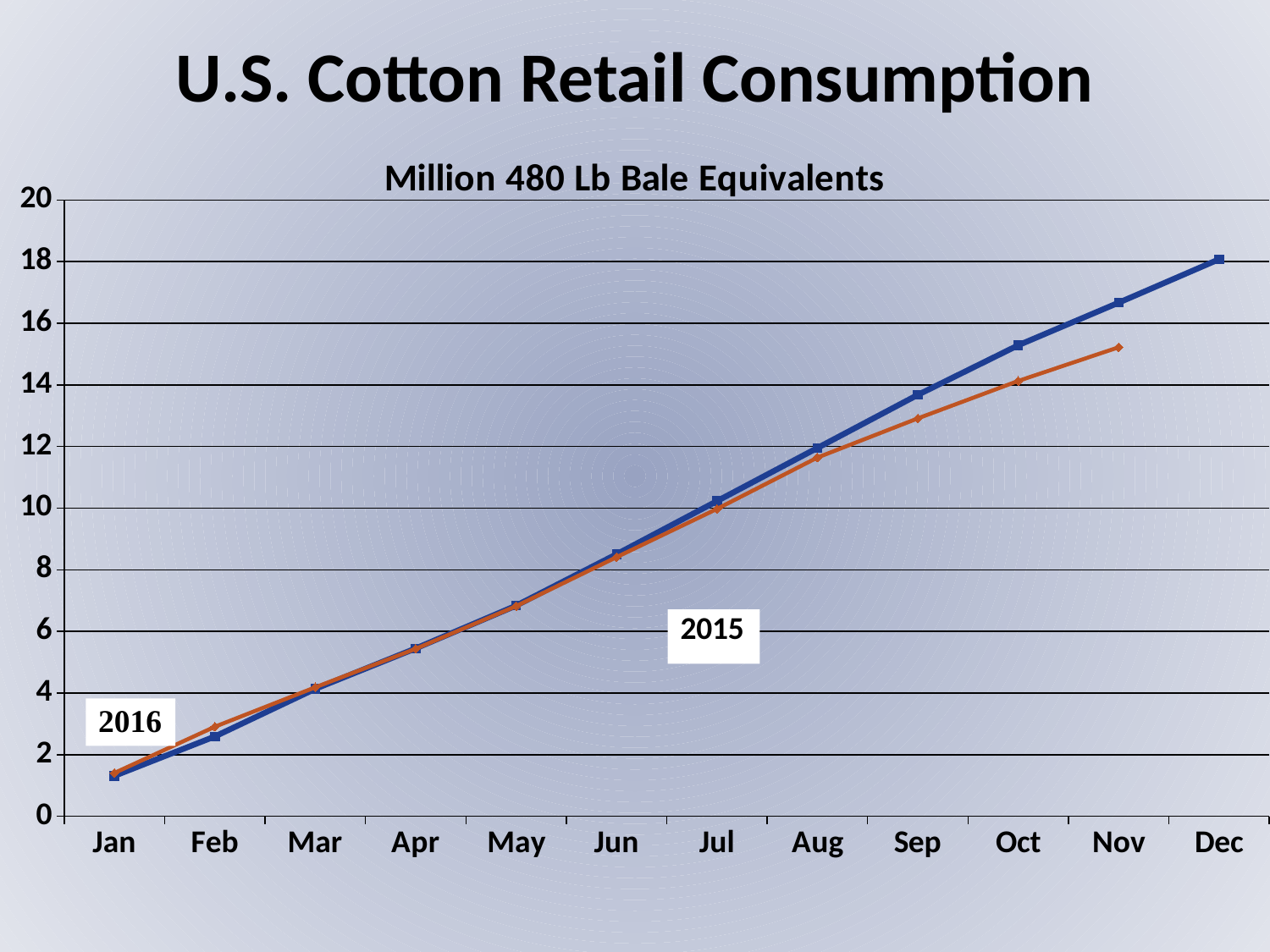
Is the value of the blue line in Jan greater or less than 2? less Is the value of the blue line in Sep greater or less than 14? less Is the value of the orange line in Nov greater or less than 14? greater How many months are shown along the x axis? 12 What is the subtitle shown above the chart indicating the units? Million 480 Lb Bale Equivalents In which month is the orange line at its lowest value? Jan What kind of chart is shown on the slide? line chart In Nov, which line has the higher value, the blue line or the orange line? the blue line Do the values of the blue line rise or fall from Jan to Dec? rise In which month does the blue line reach its highest value? Dec